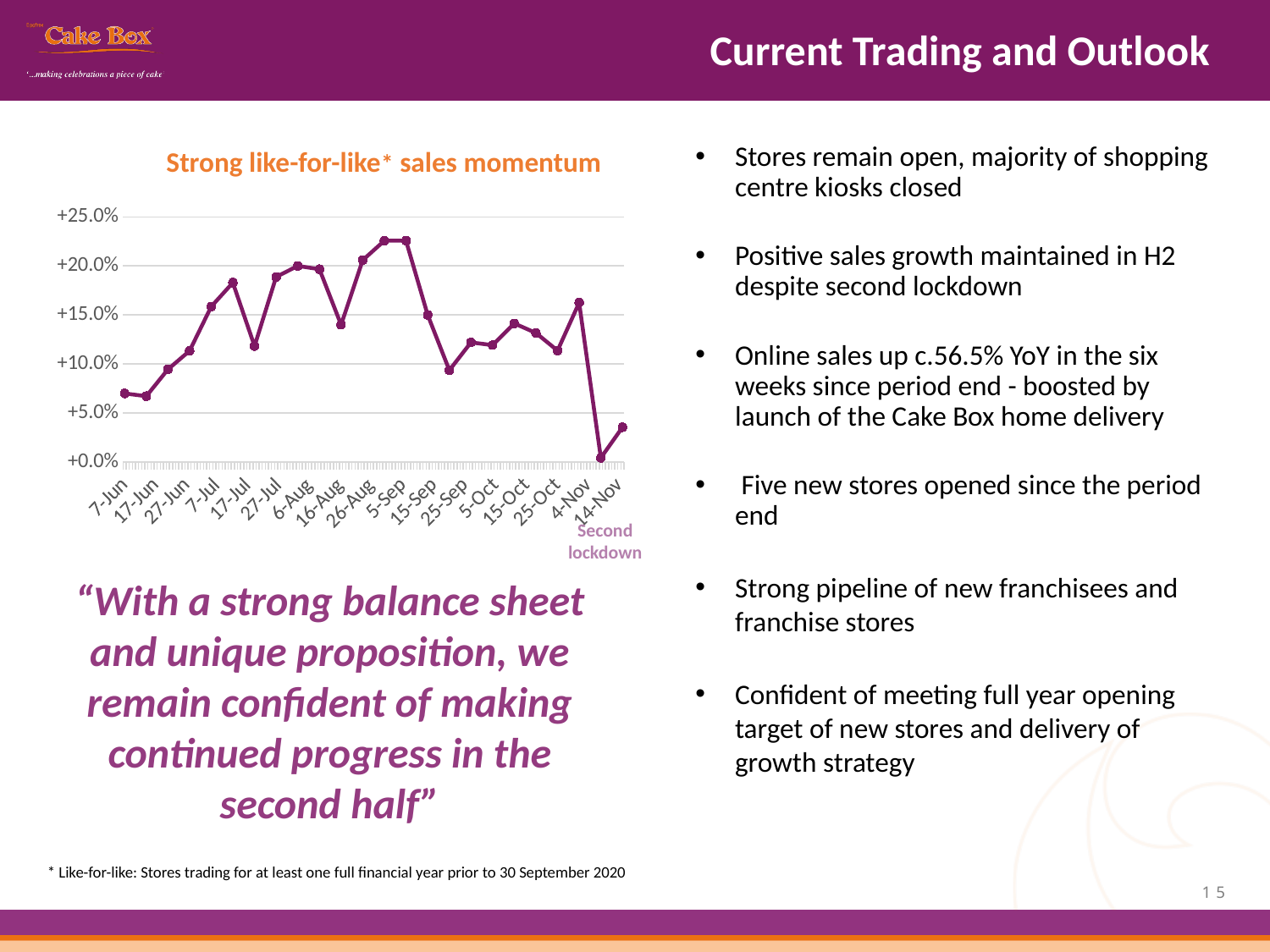
What kind of chart is shown on the slide? line chart Is the value for 7-Jun greater or less than +5.0%? greater Which is larger, the value for 7-Jun or the value for 14-Nov? 7-Jun Do the values rise or fall between 25-Oct and 14-Nov overall? fall Which is larger, the value for 7-Jul or the value for 7-Jun? 7-Jul Is the value for 7-Jun greater or less than +10.0%? less What is the title of the chart? Strong like-for-like* sales momentum Is the highest point on the line greater or less than +20.0%? greater Do the values rise or fall between 7-Jun and 7-Jul? rise What annotation is written beneath the right end of the x axis of the chart? Second lockdown What is the highest value shown on the y axis of the chart? +25.0%